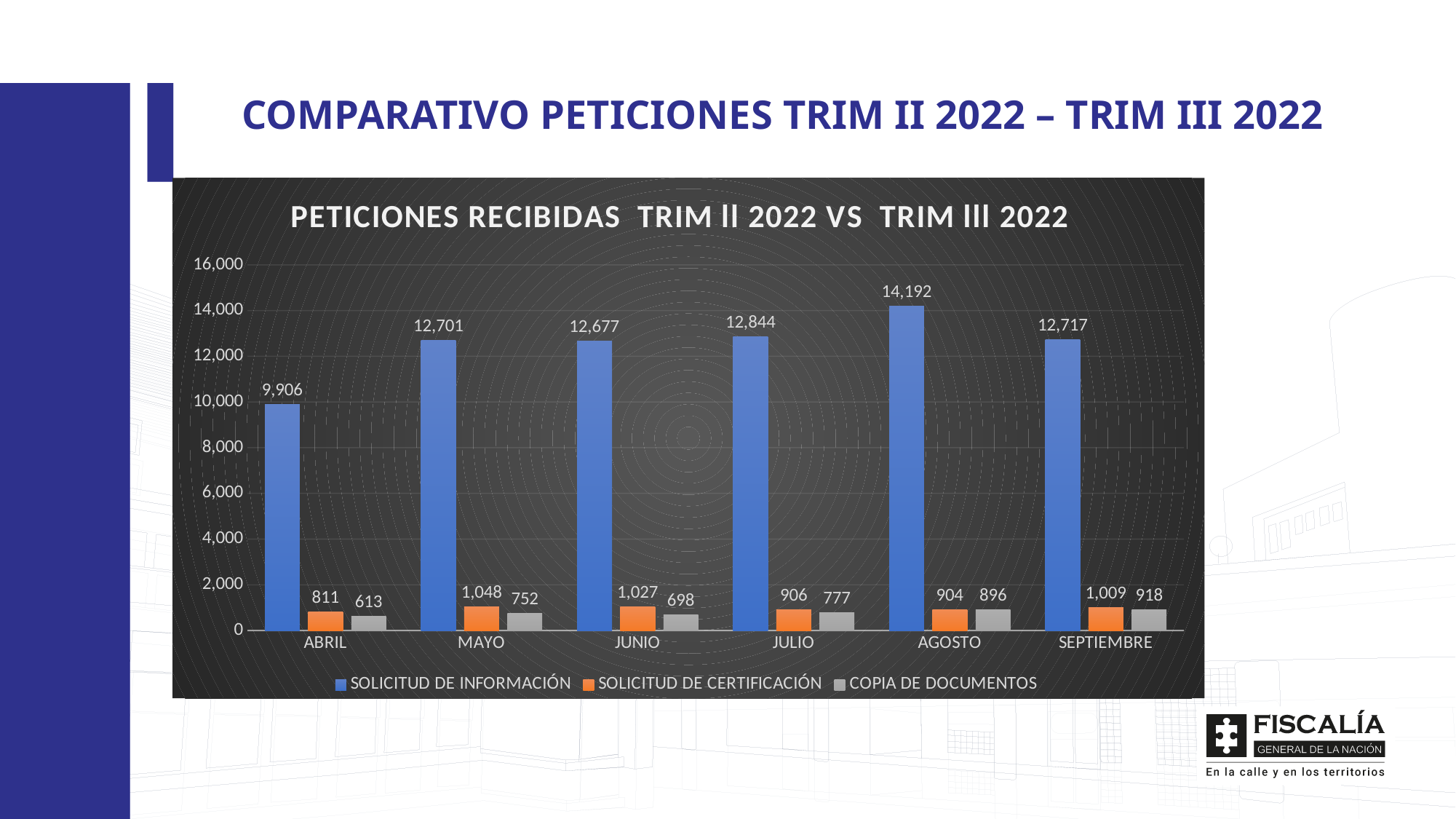
How many months are shown on the x axis? 6 Is the value of SOLICITUD DE INFORMACIÓN for ABRIL greater or less than 10,000? less What is the value of COPIA DE DOCUMENTOS for ABRIL? 613 Which is larger, COPIA DE DOCUMENTOS for SEPTIEMBRE or COPIA DE DOCUMENTOS for JUNIO? SEPTIEMBRE Which month has the lowest value for SOLICITUD DE INFORMACIÓN? ABRIL How many series does the legend list? 3 What kind of chart is shown? bar chart What is the title of the chart? PETICIONES RECIBIDAS TRIM II 2022 VS TRIM III 2022 What is the value of SOLICITUD DE CERTIFICACIÓN for MAYO? 1,048 What is the value of SOLICITUD DE INFORMACIÓN for AGOSTO? 14,192 What is the difference between the SOLICITUD DE INFORMACIÓN values for AGOSTO and ABRIL? 4,286 Which month has the highest value for SOLICITUD DE INFORMACIÓN? AGOSTO